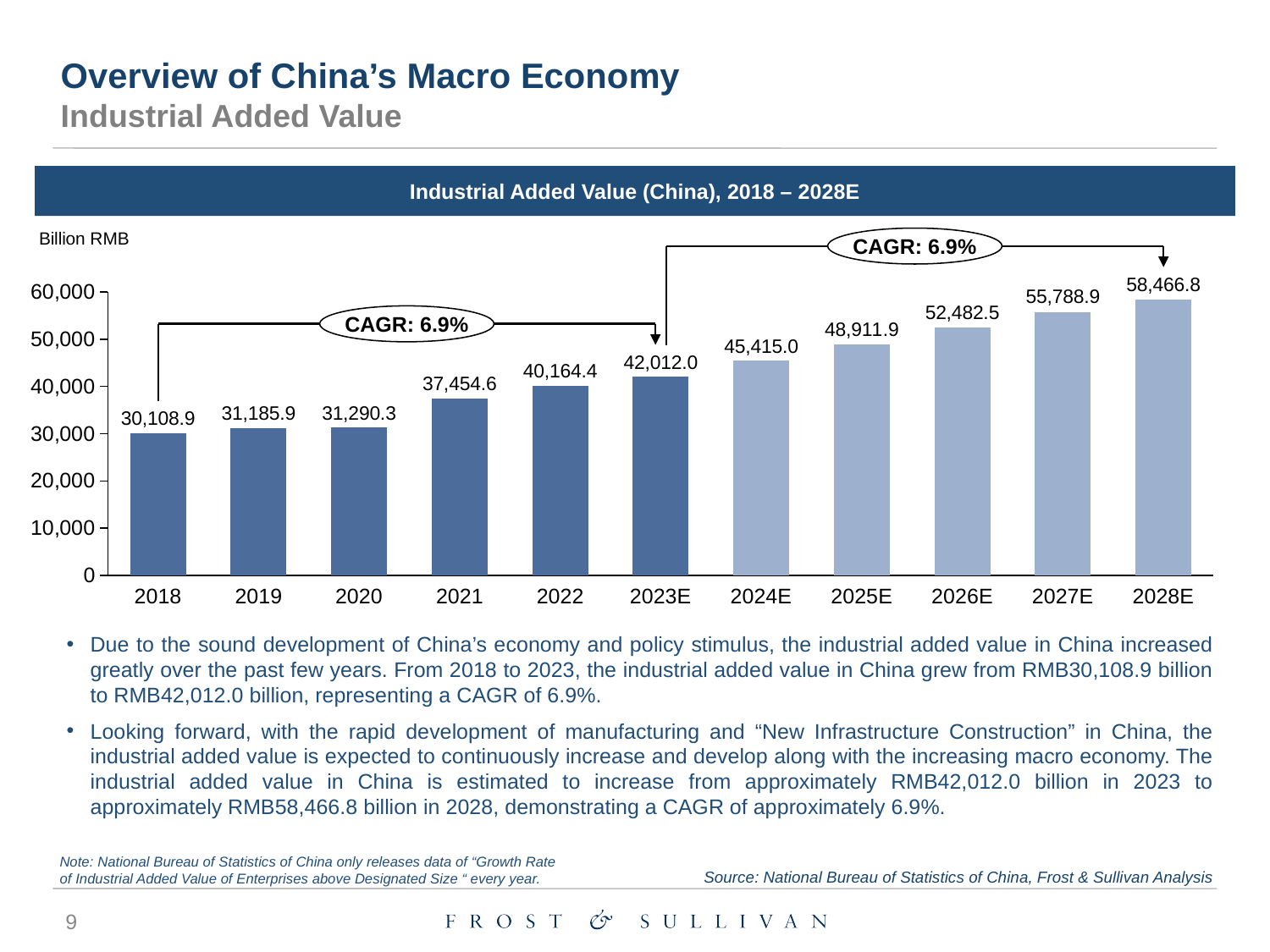
What unit is the chart measured in? Billion RMB What is the difference between the industrial added value in 2019 and 2018? 1,077.0 What is the difference between the industrial added value in 2028E and 2023E? 16,454.8 Is the value for 2026E greater or less than 50,000? greater Which year has the highest industrial added value? 2028E What is the industrial added value for 2021? 37,454.6 Do the values rise or fall from 2018 to 2028E? Rise What is the industrial added value for 2025E? 48,911.9 Which year has the lowest industrial added value? 2018 Which is larger, the industrial added value in 2022 or in 2024E? 2024E How many years are shown on the x axis? 11 What kind of chart is shown on the slide? Bar chart